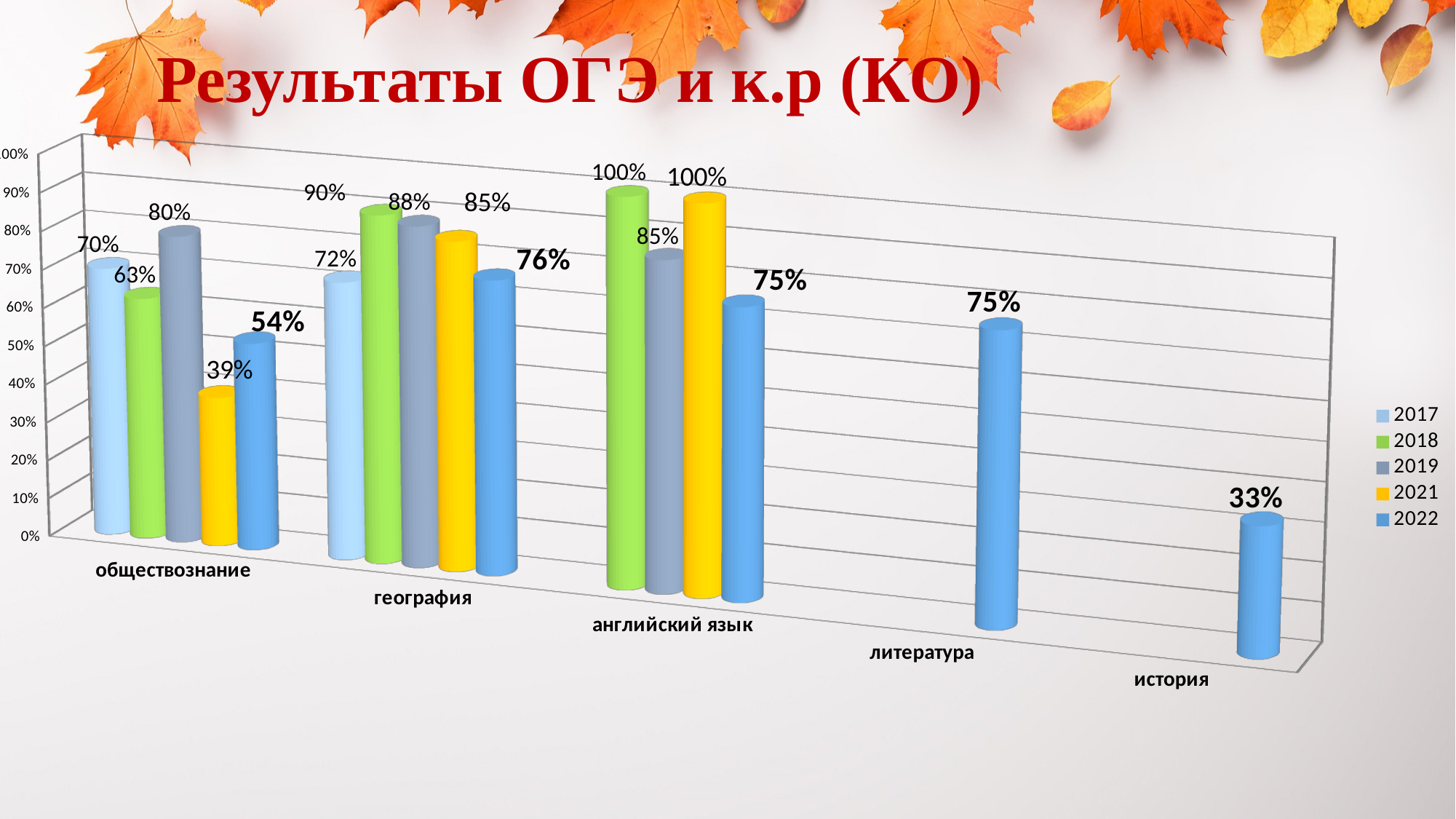
What kind of chart is shown on the slide? bar chart What is the value for история in 2022? 33% Which is larger for география: the 2017 value or the 2022 value? 2022 How many subject categories are shown on the x axis? 5 How many series does the legend list? 5 What is the value for география in 2018? 90% What is the value for обществознание in 2019? 80% What is the difference between the 2019 and 2021 values for обществознание? 41% Which year has the lowest value for обществознание? 2021 Which year has the highest value for география? 2018 What is the title of the chart? Результаты ОГЭ и к.р (КО) What is the value for английский язык in 2021? 100%